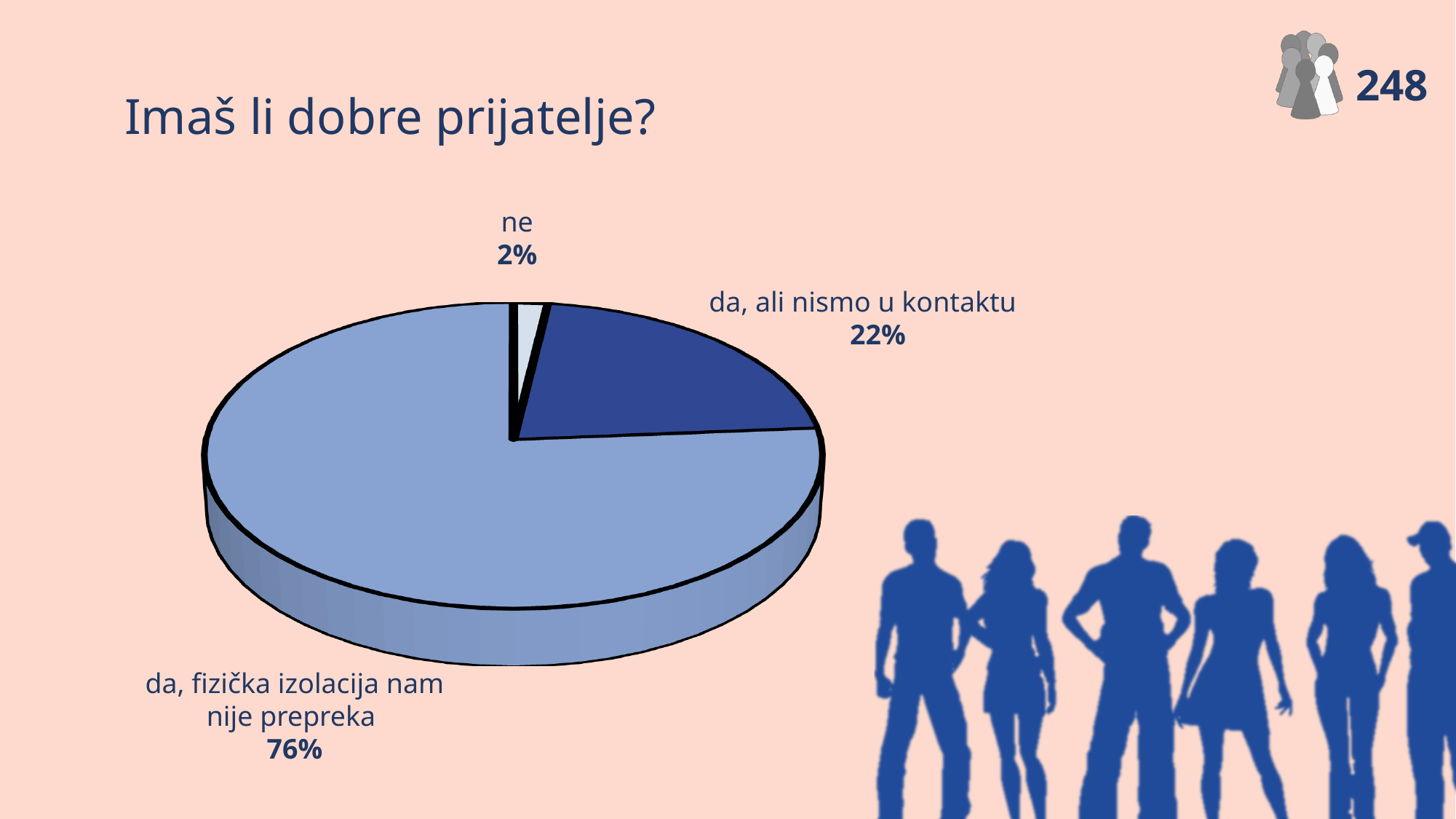
Which is larger: the share for "da, ali nismo u kontaktu" or the share for "ne"? da, ali nismo u kontaktu What percentage is shown for "da, fizička izolacija nam nije prepreka"? 76% What percentage is shown for "da, ali nismo u kontaktu"? 22% Which category has the largest share of the pie? da, fizička izolacija nam nije prepreka What number is shown next to the people icon in the top right corner of the slide? 248 What is the difference in percentage points between "da, fizička izolacija nam nije prepreka" and "da, ali nismo u kontaktu"? 54 How many slices does the pie chart have? 3 What percentage is shown for "ne"? 2% What is the difference in percentage points between "da, ali nismo u kontaktu" and "ne"? 20 What kind of chart is shown on the slide? pie chart Which category has the smallest share of the pie? ne What question is the chart's title asking? Imaš li dobre prijatelje?